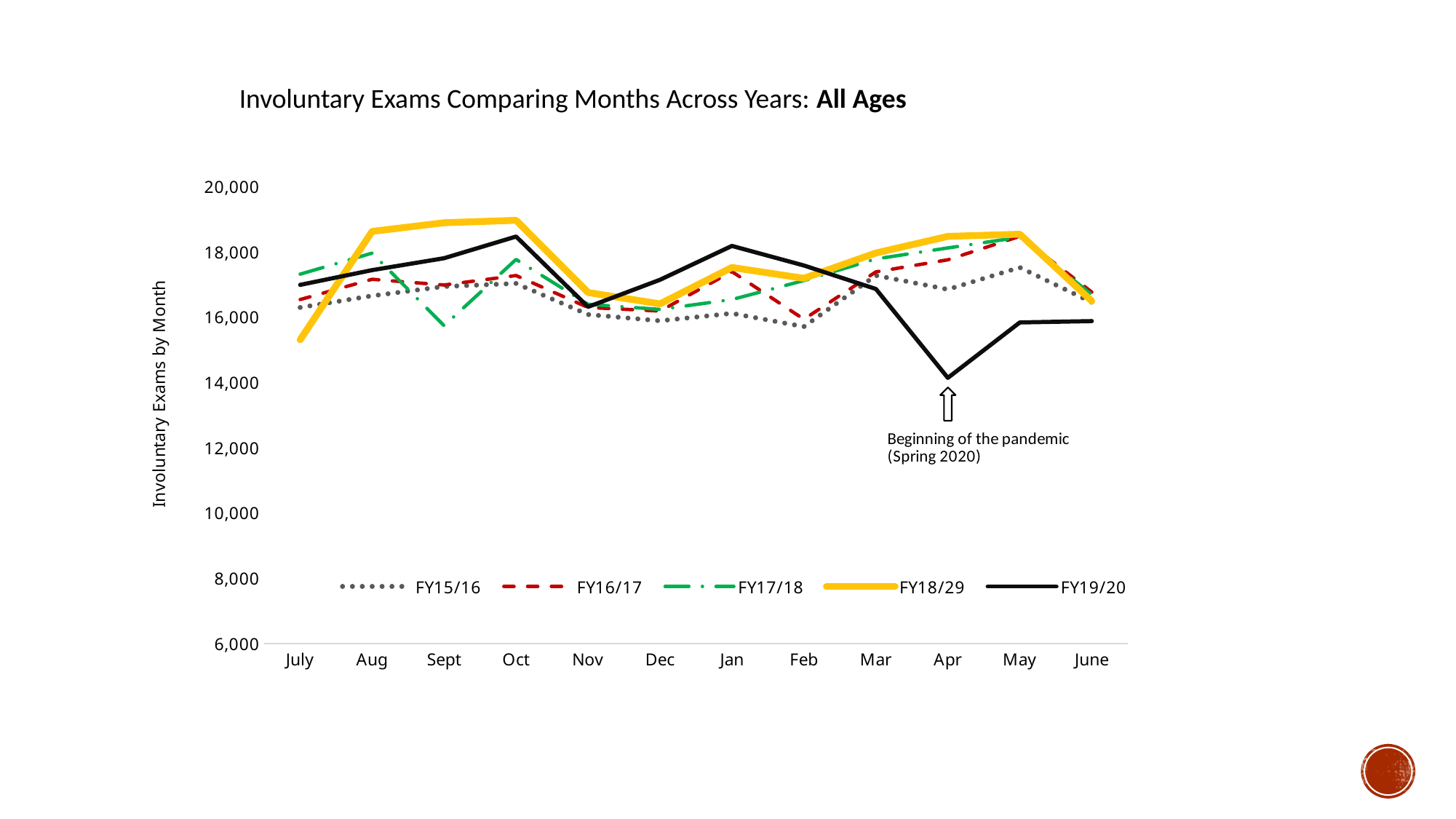
Which series has the lowest value in Apr? FY19/20 In which month does the FY19/20 series reach its lowest value? Apr Which series has the lowest value in July? FY18/29 Does the FY19/20 series rise or fall from Mar to Apr? Fall Which is larger in Apr, the FY18/29 value or the FY19/20 value? FY18/29 Is the FY19/20 value for Apr greater or less than 16,000? less What kind of chart is shown on the slide? Line chart How many series does the legend list? 5 Is the FY18/29 value for Oct greater or less than 18,000? greater Is the FY18/29 value for July greater or less than 16,000? less What event does the annotation with the arrow near Apr mark? Beginning of the pandemic (Spring 2020) How many months are shown along the x axis? 12